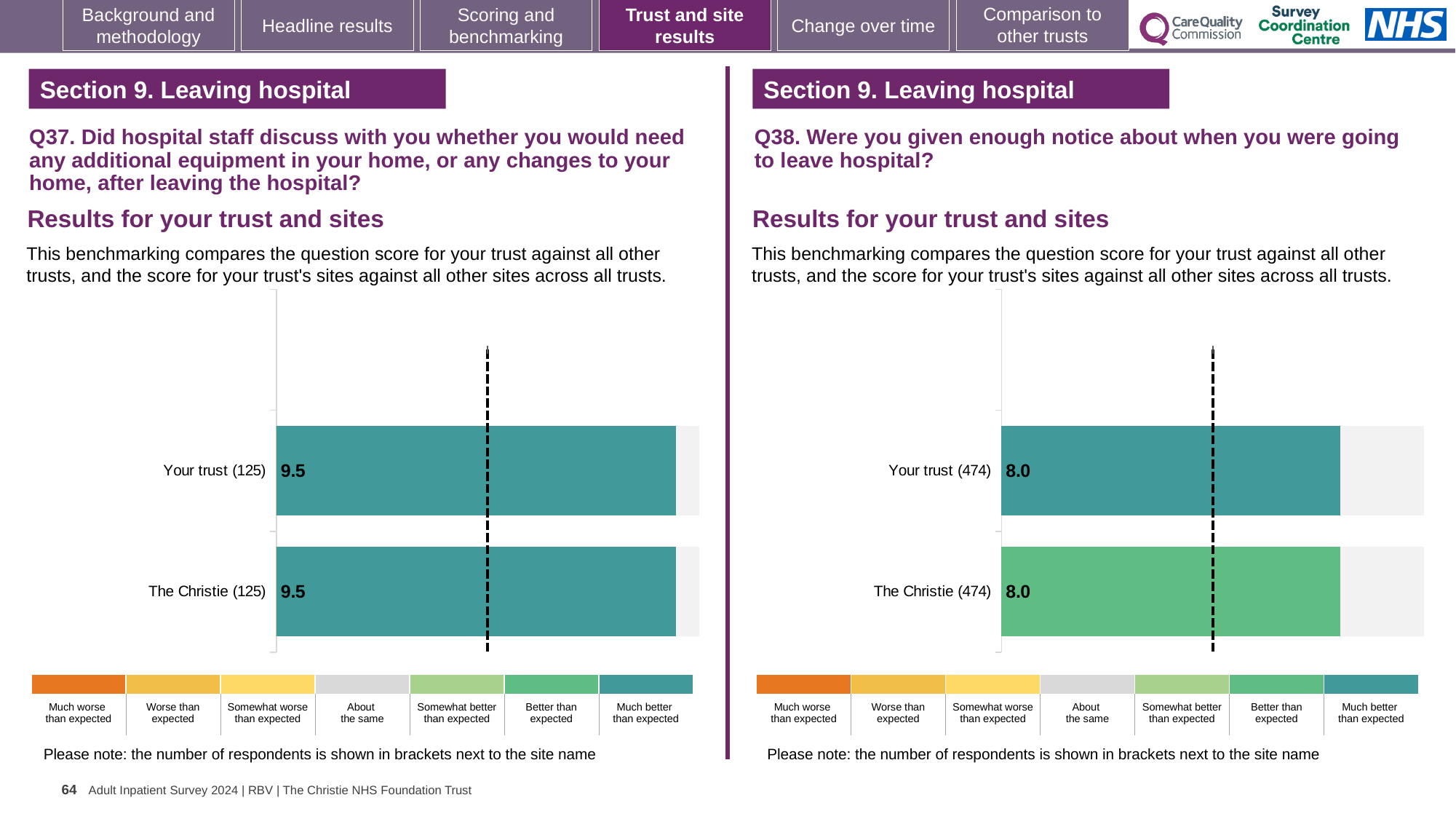
What kind of chart is the Q37 chart (left)? Bar chart On the Q38 chart (right), how many bars are plotted? 2 On the Q37 chart (left), what is the score for The Christie? 9.5 On the Q38 chart (right), what is the difference between the score for Your trust and the score for The Christie? 0.0 On the Q37 chart (left), what is the score for Your trust? 9.5 On the Q37 chart (left), what is the difference between the score for Your trust and the score for The Christie? 0.0 On the Q37 chart (left), how many respondents are shown in brackets next to Your trust? 125 On the Q38 chart (right), how many respondents are shown in brackets next to The Christie? 474 On the Q38 chart (right), what is the score for Your trust? 8.0 Is the score for Your trust on the Q37 chart (left) larger or smaller than the score for Your trust on the Q38 chart (right)? Larger On the Q37 chart (left), how many bars are plotted? 2 On the Q38 chart (right), what is the score for The Christie? 8.0